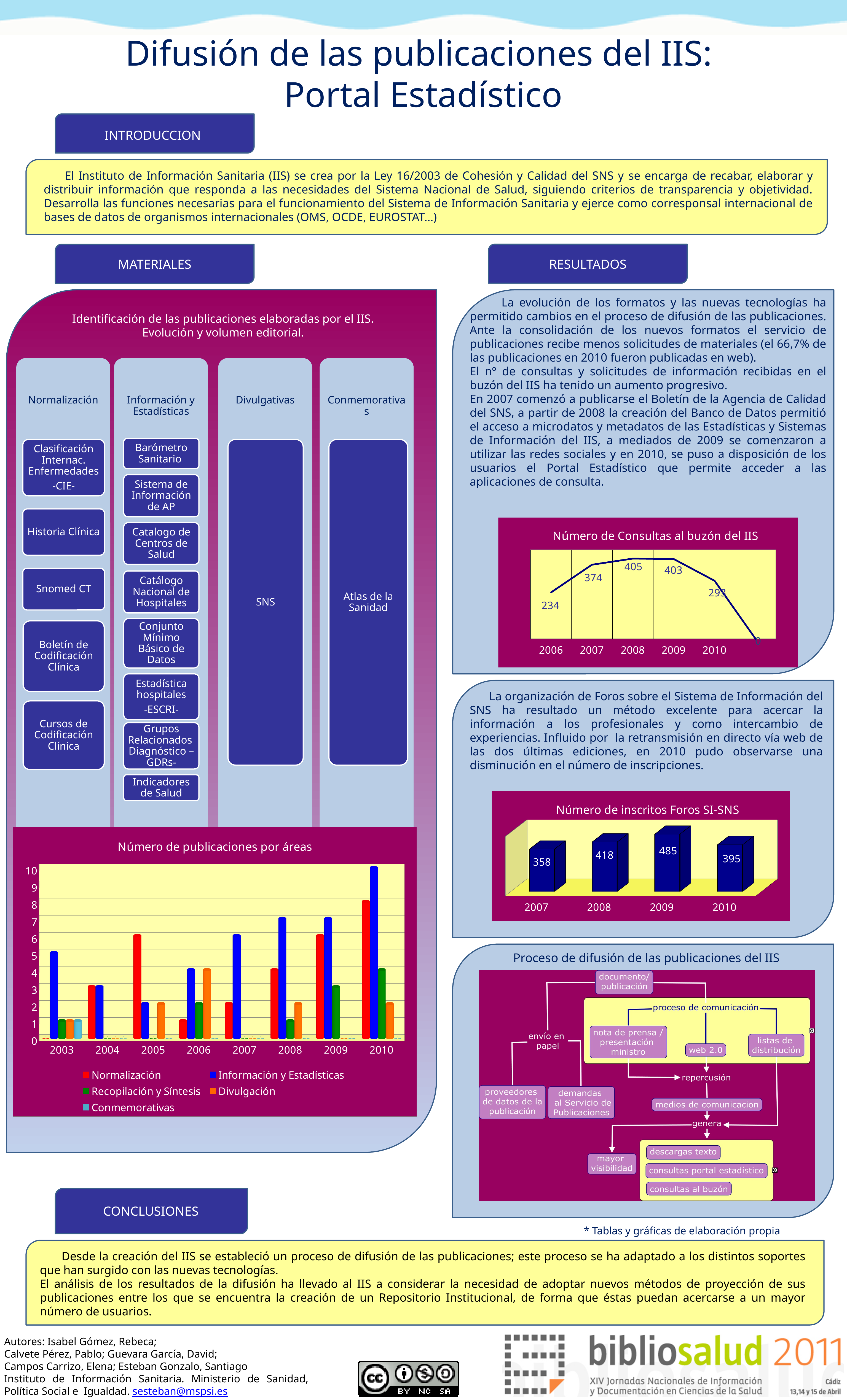
What kind of chart is 'Número de inscritos Foros SI-SNS'? bar chart In the chart 'Número de Consultas al buzón del IIS', which labelled year has the lowest value? 2006 In the chart 'Número de publicaciones por áreas', is the value for Información y Estadísticas in 2010 greater or less than 8? greater In the chart 'Número de publicaciones por áreas', how many series does the legend list? 5 In the chart 'Número de publicaciones por áreas', which is larger in 2010: Normalización or Información y Estadísticas? Información y Estadísticas In the chart 'Número de Consultas al buzón del IIS', what is the value for 2006? 234 In the chart 'Número de inscritos Foros SI-SNS', which year has the highest value? 2009 In the chart 'Número de Consultas al buzón del IIS', what is the value for 2010? 293 In the chart 'Número de inscritos Foros SI-SNS', what is the difference between the values for 2009 and 2010? 90 In the chart 'Número de Consultas al buzón del IIS', what is the difference between the values for 2008 and 2007? 31 In the chart 'Número de inscritos Foros SI-SNS', what is the value for 2008? 418 In the chart 'Número de inscritos Foros SI-SNS', how many years are shown? 4